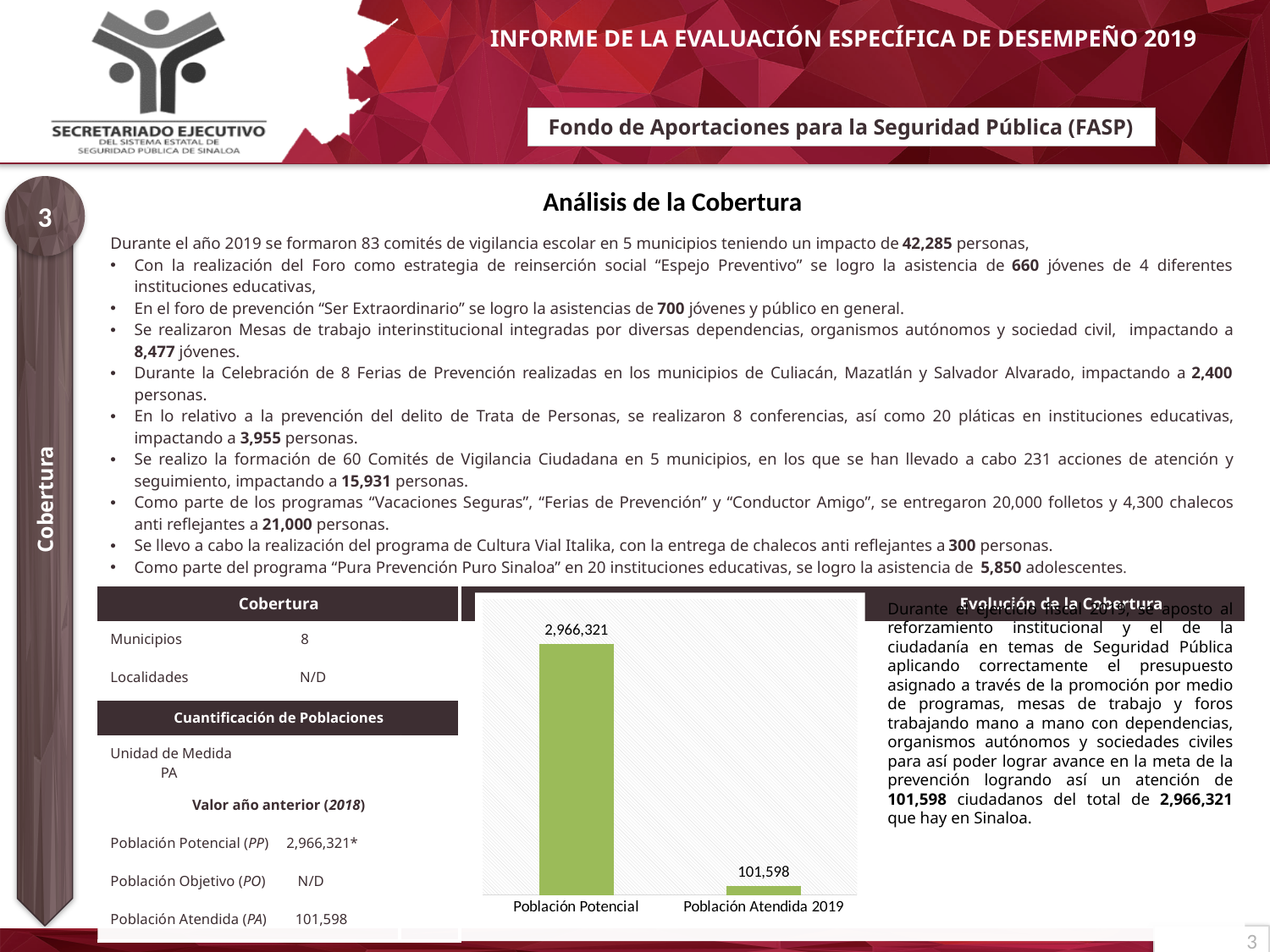
Do the values rise or fall from left to right across the chart? Fall How many categories are shown in the chart? 2 Which category has the lowest value in the chart? Población Atendida 2019 What colour are the bars in the chart? Green What is the difference between the values for Población Potencial and Población Atendida 2019? 2,864,723 What is the value for Población Atendida 2019 in the chart? 101,598 What kind of chart is shown on the slide? Bar chart Which is larger, the value for Población Potencial or the value for Población Atendida 2019? Población Potencial What is the value for Población Potencial in the chart? 2,966,321 Which category has the highest value in the chart? Población Potencial What is the title of the chart? Evolución de la Cobertura